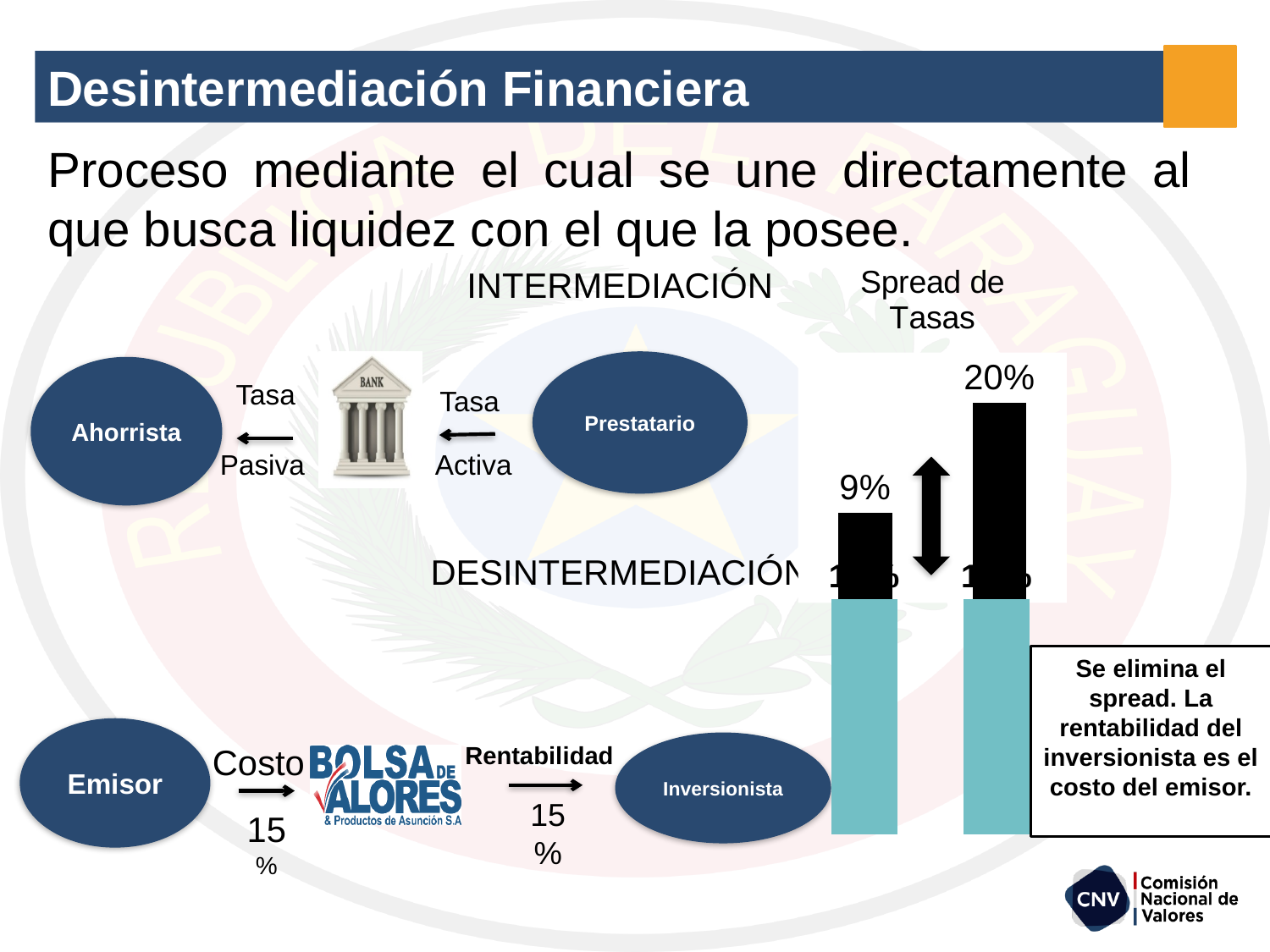
What two colours are used for the segments of the bars in the chart? black and teal What value is printed above the black segment of the left bar in the chart? 9% What kind of chart is shown on the slide? bar chart What heading appears above the chart? Spread de Tasas What is the difference between the black segment values of the right bar (20%) and the left bar (9%)? 11% Which black segment value is the highest in the chart? 20% Which bar has the larger black segment, the left bar or the right bar? the right bar Which black segment value is the lowest in the chart? 9% What value is printed above the black segment of the right bar in the chart? 20%